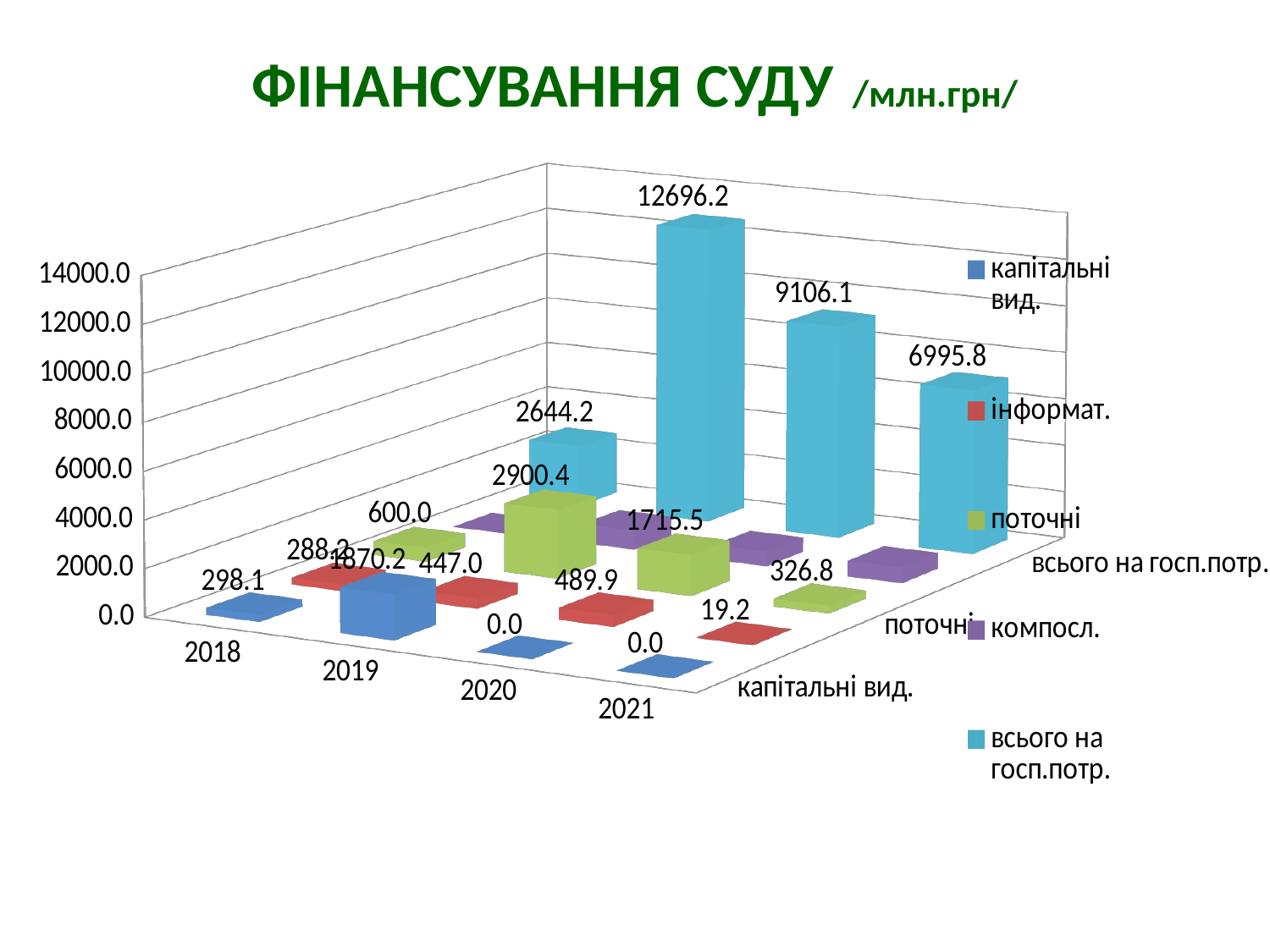
What is the value for всього на госп.потр. in 2021? 6995.8 In which year is всього на госп.потр. the lowest? 2018 In which year is всього на госп.потр. the highest? 2019 What kind of chart is shown on the slide? bar chart What is the difference between всього на госп.потр. in 2019 and in 2020? 3590.1 How many years are shown on the x axis? 4 What is the value for капітальні вид. in 2020? 0.0 What is the value for інформат. in 2021? 19.2 How many series does the legend list? 5 Does the value for всього на госп.потр. rise or fall from 2019 to 2021? fall Which year has the larger value for поточні: 2019 or 2020? 2019 What is the value for всього на госп.потр. in 2019? 12696.2